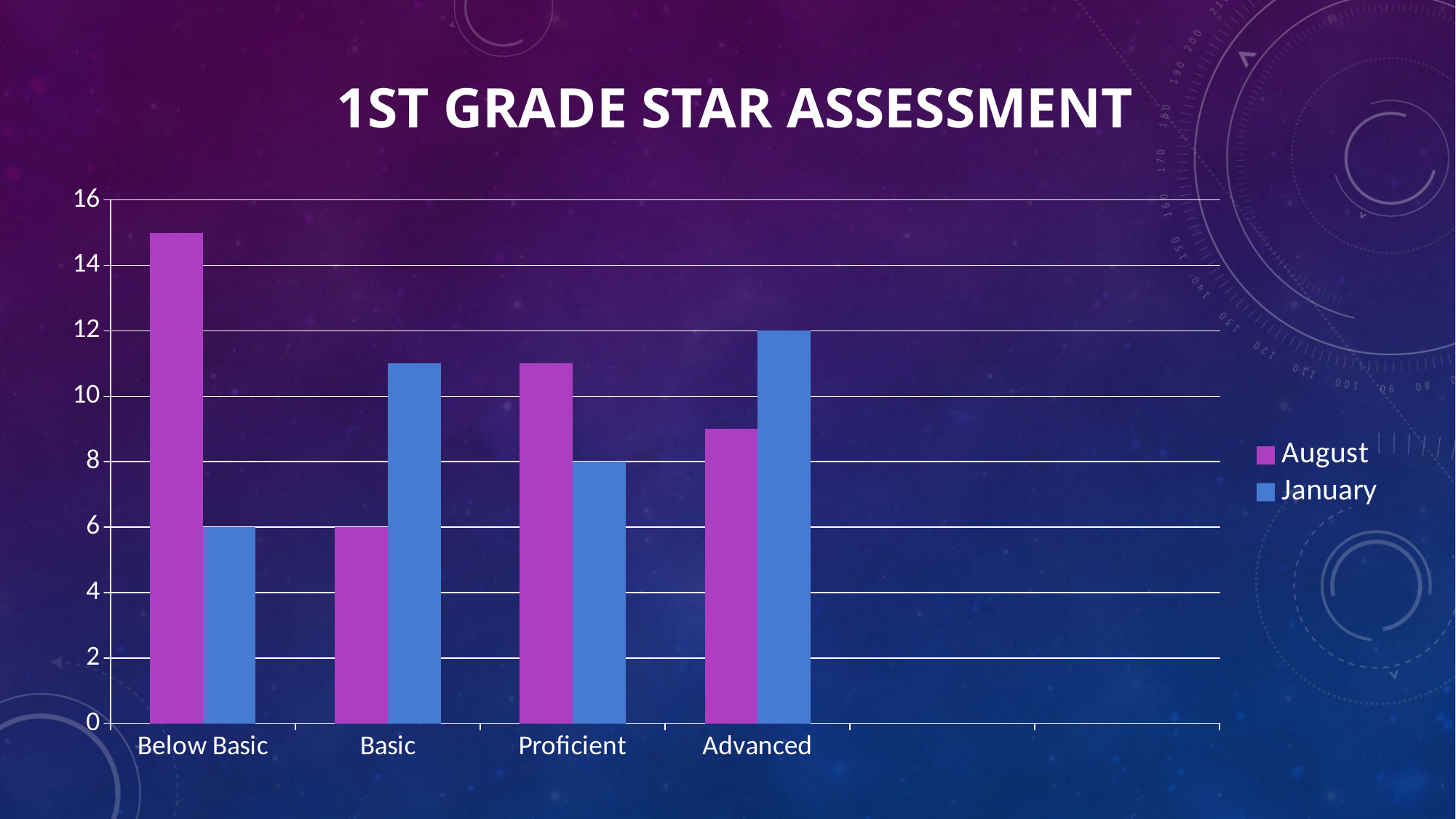
Is the August value for Below Basic greater or less than 14? greater What type of chart is shown on the slide? bar chart Is the August value for Advanced greater or less than 10? less How many series does the legend list? 2 What is the January value for Proficient? 8 What is the January value for Below Basic? 6 What is the title of the chart? 1st Grade Star Assessment Which category has the highest August value? Below Basic How many categories are shown on the x axis? 4 What is the January value for Advanced? 12 For Proficient, which is larger, the August value or the January value? August Which category has the lowest January value? Below Basic